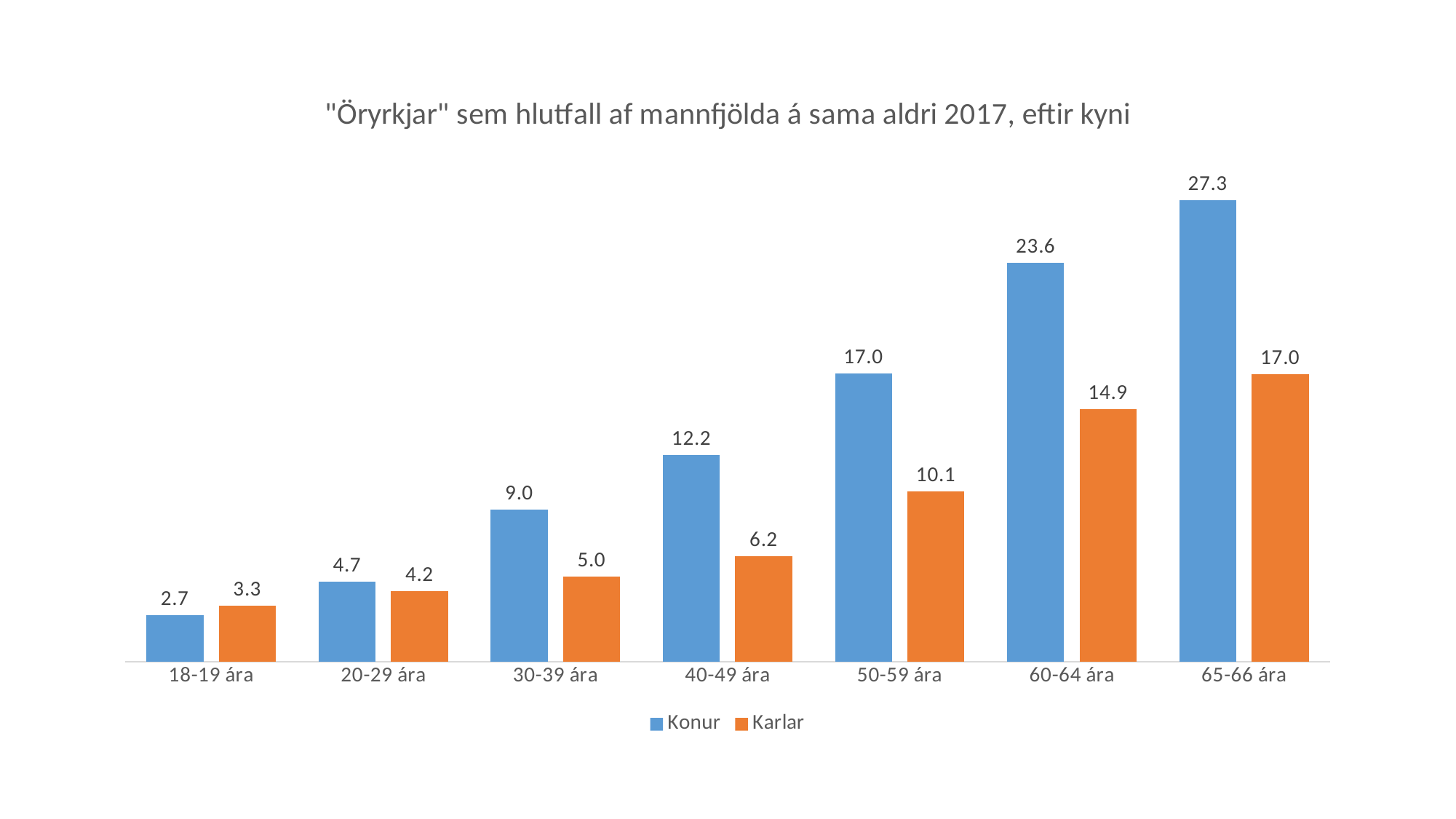
What is the difference between the Konur and Karlar values in the 65-66 ára age group? 10.3 What is the value for Karlar in the 18-19 ára age group? 3.3 What is the difference between the Konur values for 60-64 ára and 50-59 ára? 6.6 What kind of chart is shown on the slide? Bar chart How many series does the legend list? 2 Which age group has the lowest value for Karlar? 18-19 ára What is the value for Konur in the 40-49 ára age group? 12.2 In the 18-19 ára age group, which is larger, Konur or Karlar? Karlar How many age groups are shown on the x axis? 7 Do the Konur values rise or fall as the age groups increase along the x axis? Rise What is the value for Karlar in the 60-64 ára age group? 14.9 Which age group has the highest value for Konur? 65-66 ára